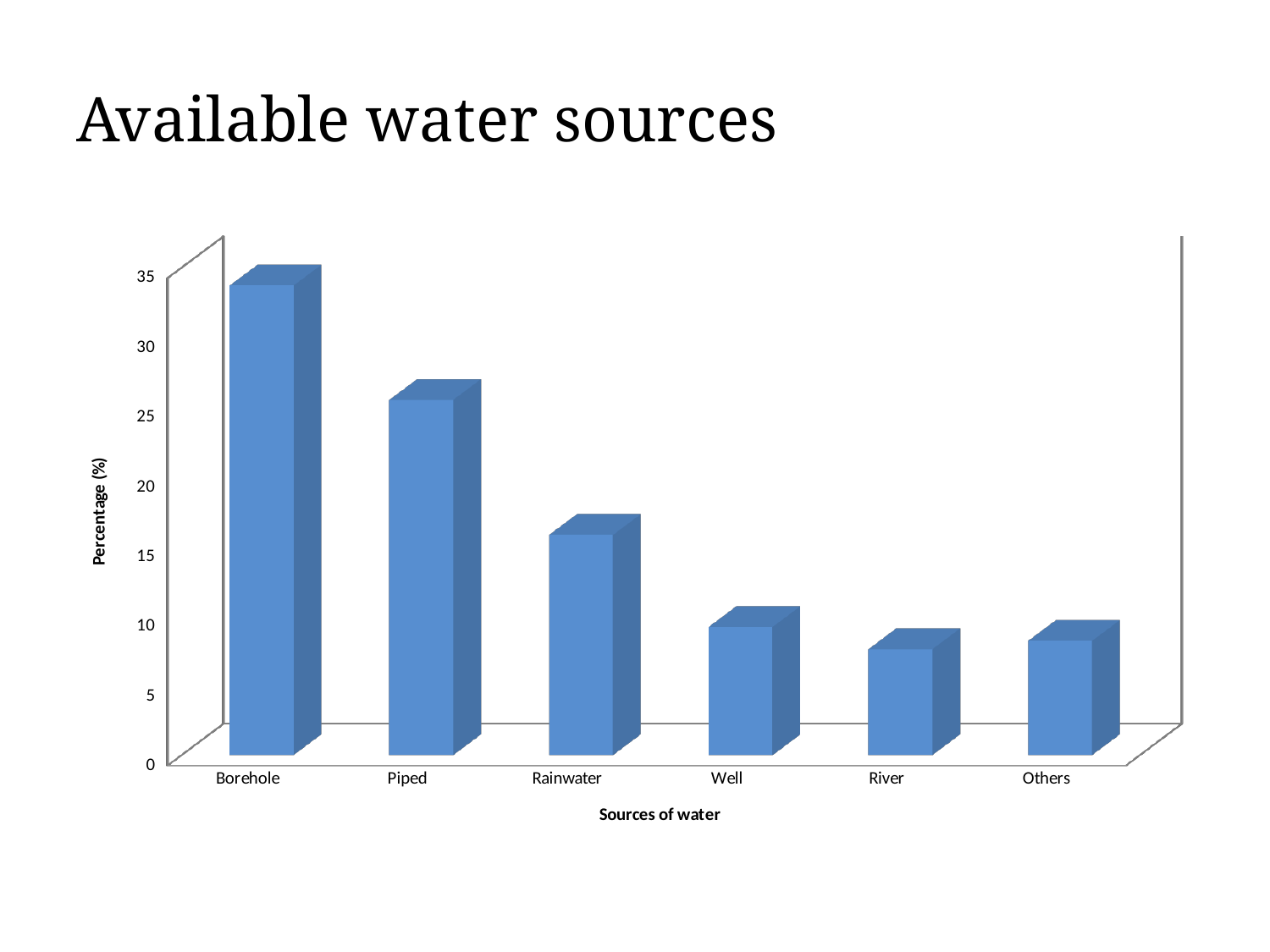
Which has a larger percentage, Well or River? Well Is the value for River greater or less than 10? less What is the label of the vertical axis of the chart? Percentage (%) Is the value for Rainwater greater or less than 20? less Is the value for Piped greater or less than 30? less What kind of chart is shown on the slide? bar chart How many water sources are shown on the x axis of the chart? 6 Which water source has the highest percentage in the chart? Borehole What is the label of the horizontal axis of the chart? Sources of water Which has a larger percentage, Piped or Rainwater? Piped